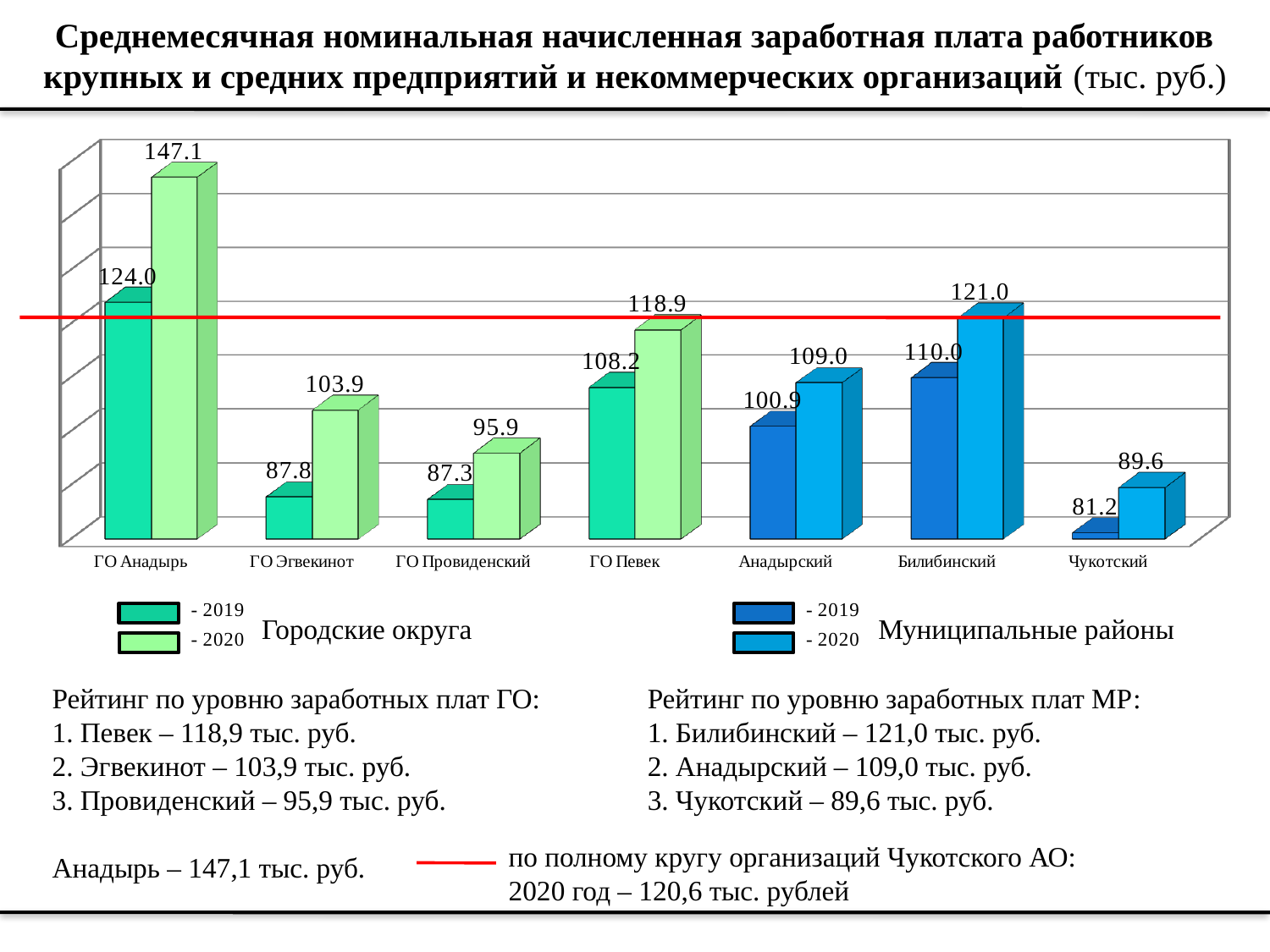
What type of chart is shown on the slide? Bar chart Which category has the lowest 2019 value? Чукотский What is the 2020 value for Чукотский? 89.6 Which is larger: the 2020 value for ГО Певек or the 2020 value for Билибинский? Билибинский How many categories are shown on the x axis? 7 What is the 2020 value for ГО Анадырь? 147.1 Which category has the highest 2020 value? ГО Анадырь What value does the red horizontal line represent? 120,6 тыс. рублей What is the difference between the 2020 and 2019 values for ГО Эгвекинот? 16.1 What is the 2019 value for ГО Провиденский? 87.3 For each category, does the value rise or fall from 2019 to 2020? Rises What is the 2019 value for Билибинский? 110.0